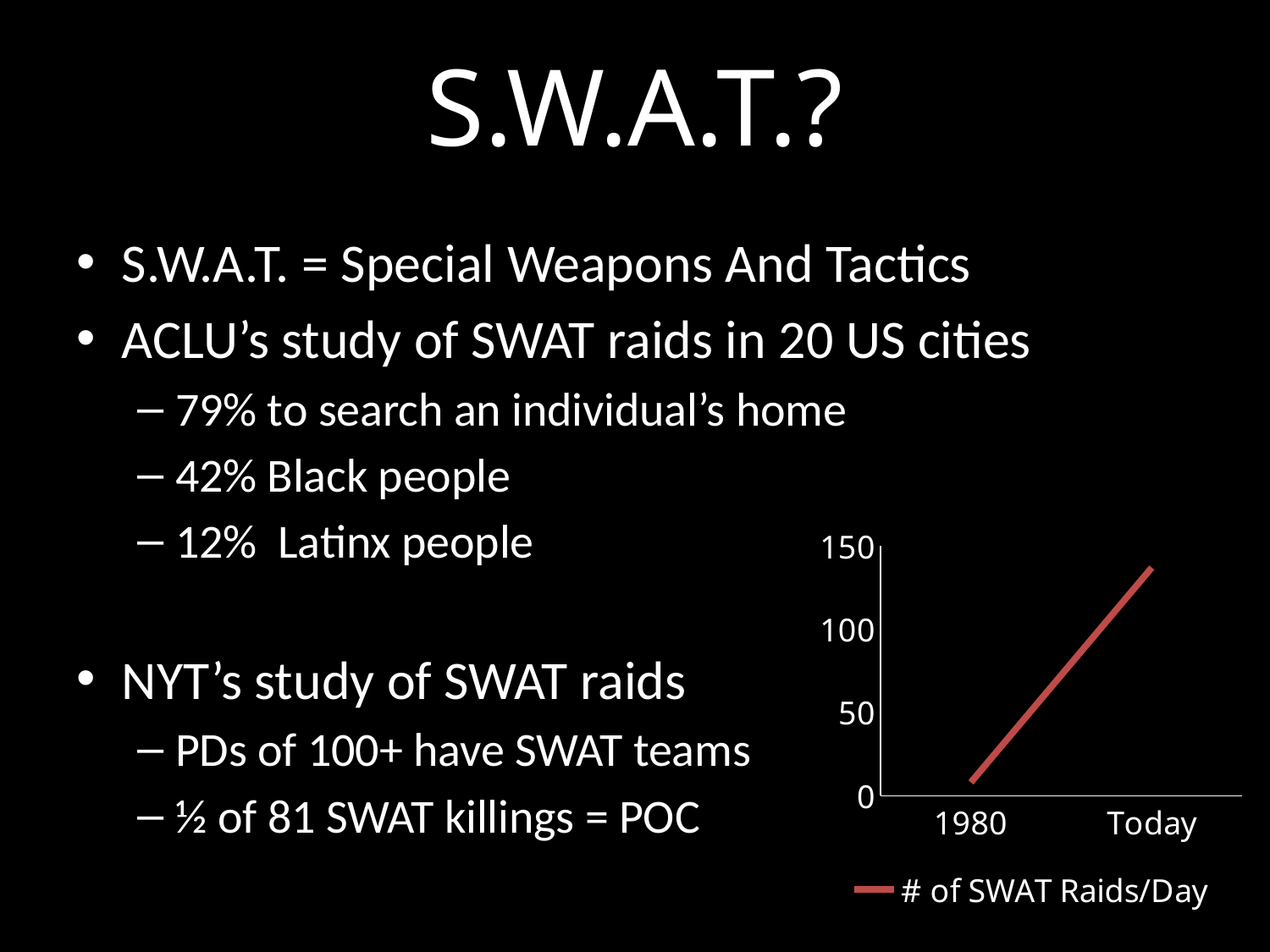
Which has the larger value, 1980 or Today? Today What kind of chart is shown on the slide? line chart What is the name of the series shown in the chart's legend? # of SWAT Raids/Day How many points are plotted on the chart? 2 Is the value for Today greater or less than 150? less Which x-axis category has the highest value? Today Is the value for 1980 greater or less than 50? less What colour is the line in the chart? red How many series does the chart's legend list? 1 Is the value for Today greater or less than 100? greater Which x-axis category has the lowest value? 1980 Does the number of SWAT raids per day rise or fall from 1980 to Today? rise